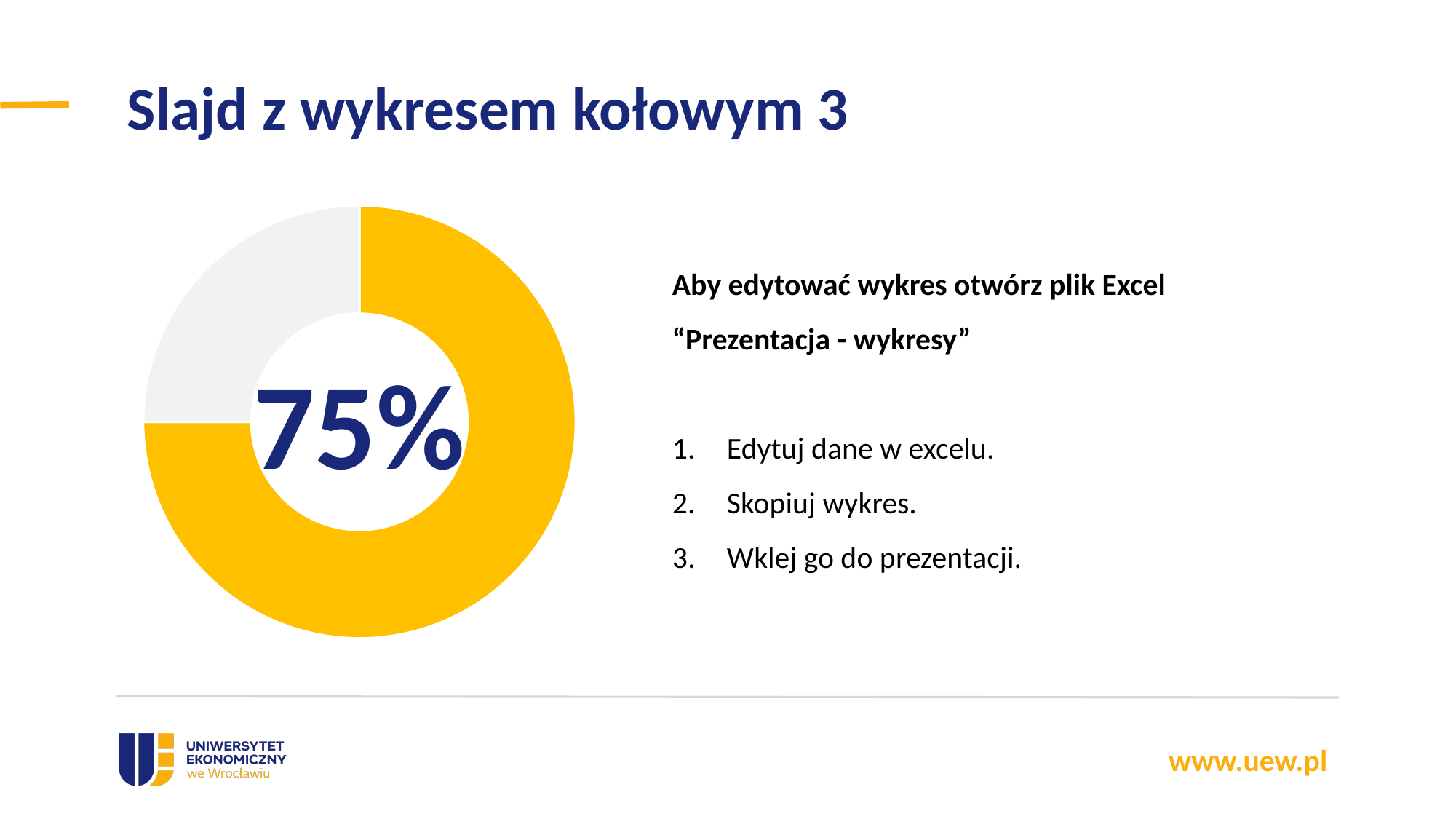
What is the title of the slide containing the donut chart? Slajd z wykresem kołowym 3 What share of the donut chart does the yellow slice represent? 75% Is the share of the yellow slice greater or less than 50%? greater What percentage is printed in the centre of the donut chart? 75% How many slices does the donut chart have? 2 Is the share of the grey slice greater or less than 50%? less What colour is the largest slice of the donut chart? Yellow What share of the donut chart does the grey slice represent? 25% Which slice of the donut chart is larger, the yellow one or the grey one? The yellow one What kind of chart is shown on the slide? Pie chart (donut)